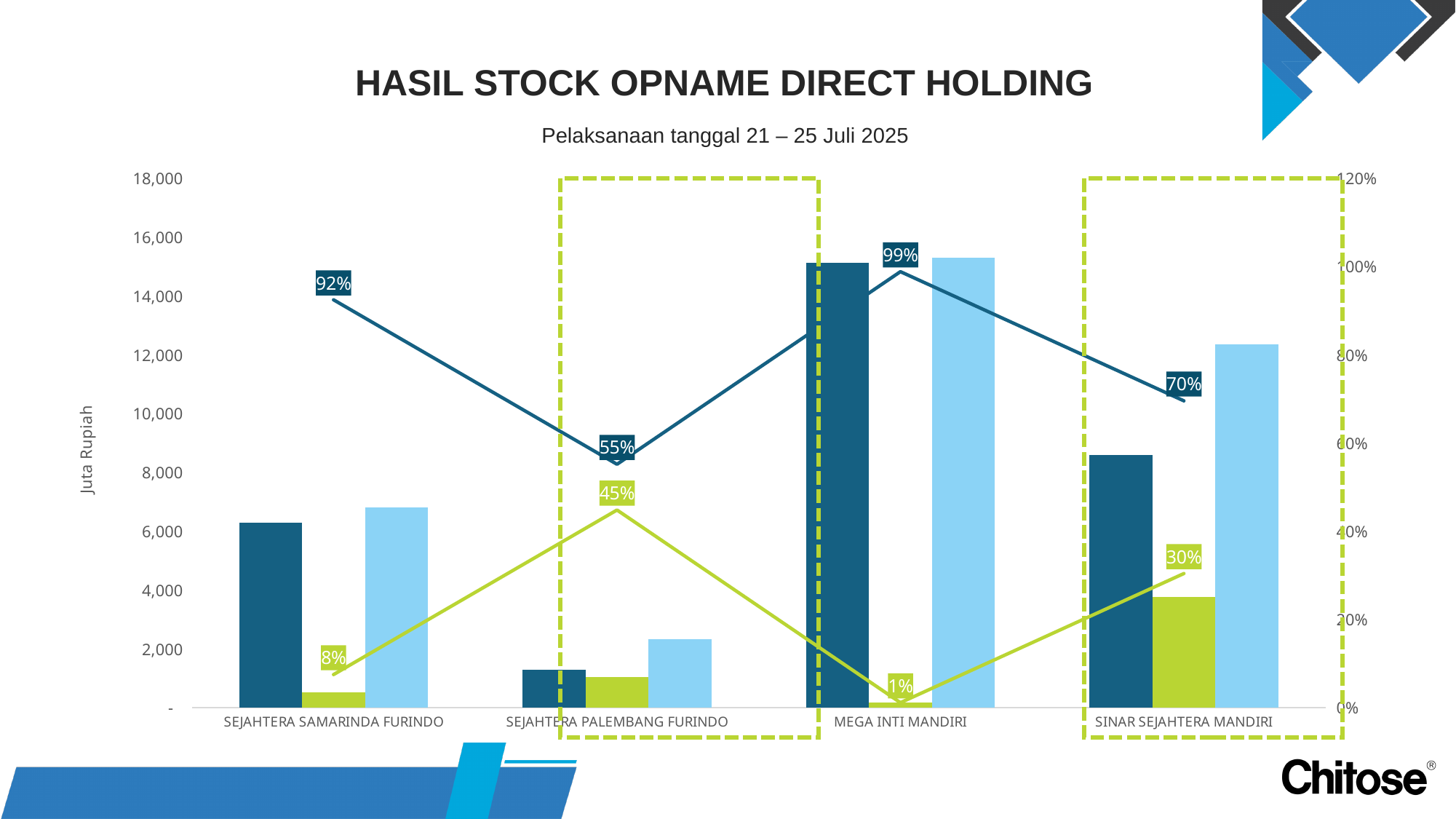
How many categories are shown on the x axis? 4 What is the difference between the dark blue line values for SEJAHTERA SAMARINDA FURINDO and SINAR SEJAHTERA MANDIRI? 22 percentage points What value does the green line show for SEJAHTERA PALEMBANG FURINDO? 45% What value does the dark blue line show for MEGA INTI MANDIRI? 99% Which category has the highest value on the dark blue line? MEGA INTI MANDIRI Is the dark blue bar for MEGA INTI MANDIRI greater or less than 14,000? greater Which category has the lowest value on the green line? MEGA INTI MANDIRI What is the label on the left vertical axis? Juta Rupiah Is the light blue bar for SEJAHTERA PALEMBANG FURINDO greater or less than 4,000? less What value does the green line show for SINAR SEJAHTERA MANDIRI? 30% What value does the dark blue line show for SEJAHTERA SAMARINDA FURINDO? 92% What kind of chart is shown on the slide? Combination bar and line chart